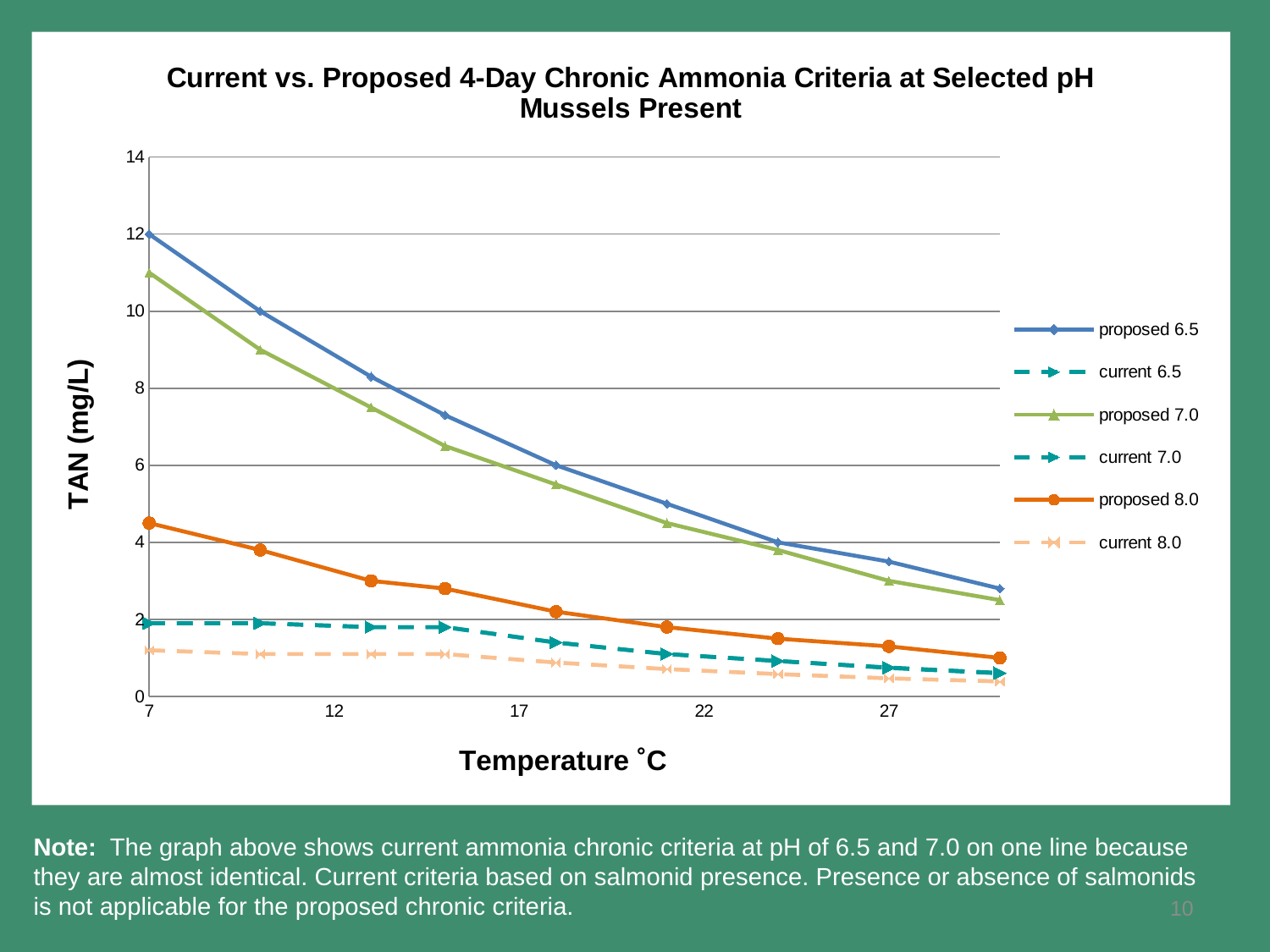
Which series has the highest value at 7 °C? proposed 6.5 Is the value for current 8.0 at 7 °C greater or less than 2? less Do the values of the proposed 6.5 series rise or fall as temperature increases? fall What kind of chart is shown on the slide? line chart Is the value for proposed 6.5 at 27 °C greater or less than 4? less Which series has the lowest value at 7 °C? current 8.0 Is the value for proposed 7.0 at 7 °C greater or less than 10? greater How many series does the legend list? 6 What is the label of the y axis? TAN (mg/L) What is the value of the proposed 6.5 series at 7 °C? 12 At 7 °C, which is larger: proposed 6.5 or proposed 7.0? proposed 6.5